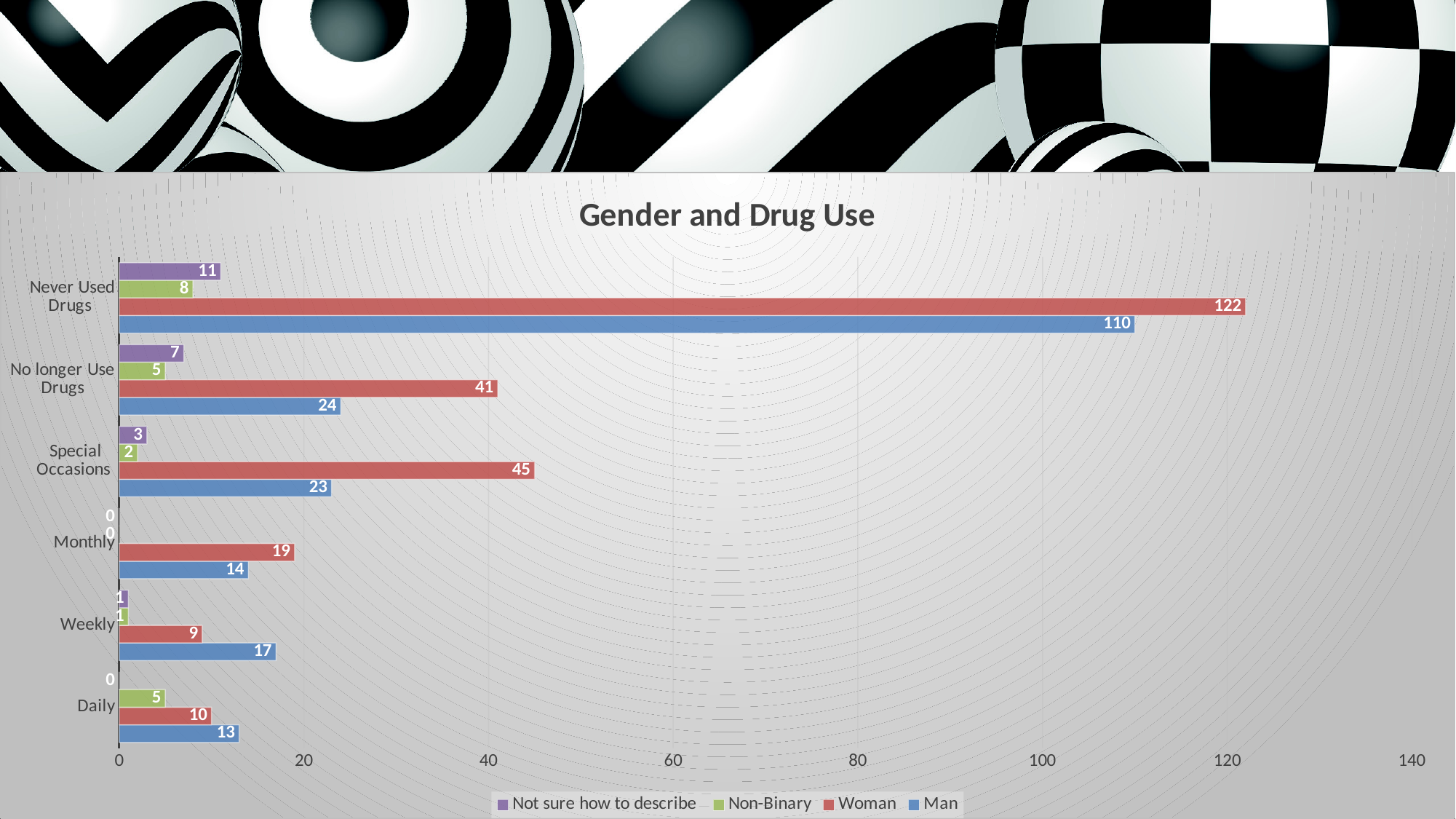
Which category has the highest value for the Man series? Never Used Drugs How many series does the legend list? 4 What kind of chart is shown on the slide? Bar chart Which category has the lowest value for the Woman series? Weekly What is the difference between the Woman and Man values in the Never Used Drugs category? 12 What is the value for Man in the Weekly category? 17 What is the value for Non-Binary in the Daily category? 5 Which is larger in the Special Occasions category, the Woman value or the Man value? Woman How many categories are shown on the vertical axis? 6 What is the value for Woman in the Never Used Drugs category? 122 What is the title of the chart? Gender and Drug Use Is the value for Man in the Never Used Drugs category greater or less than 100? greater